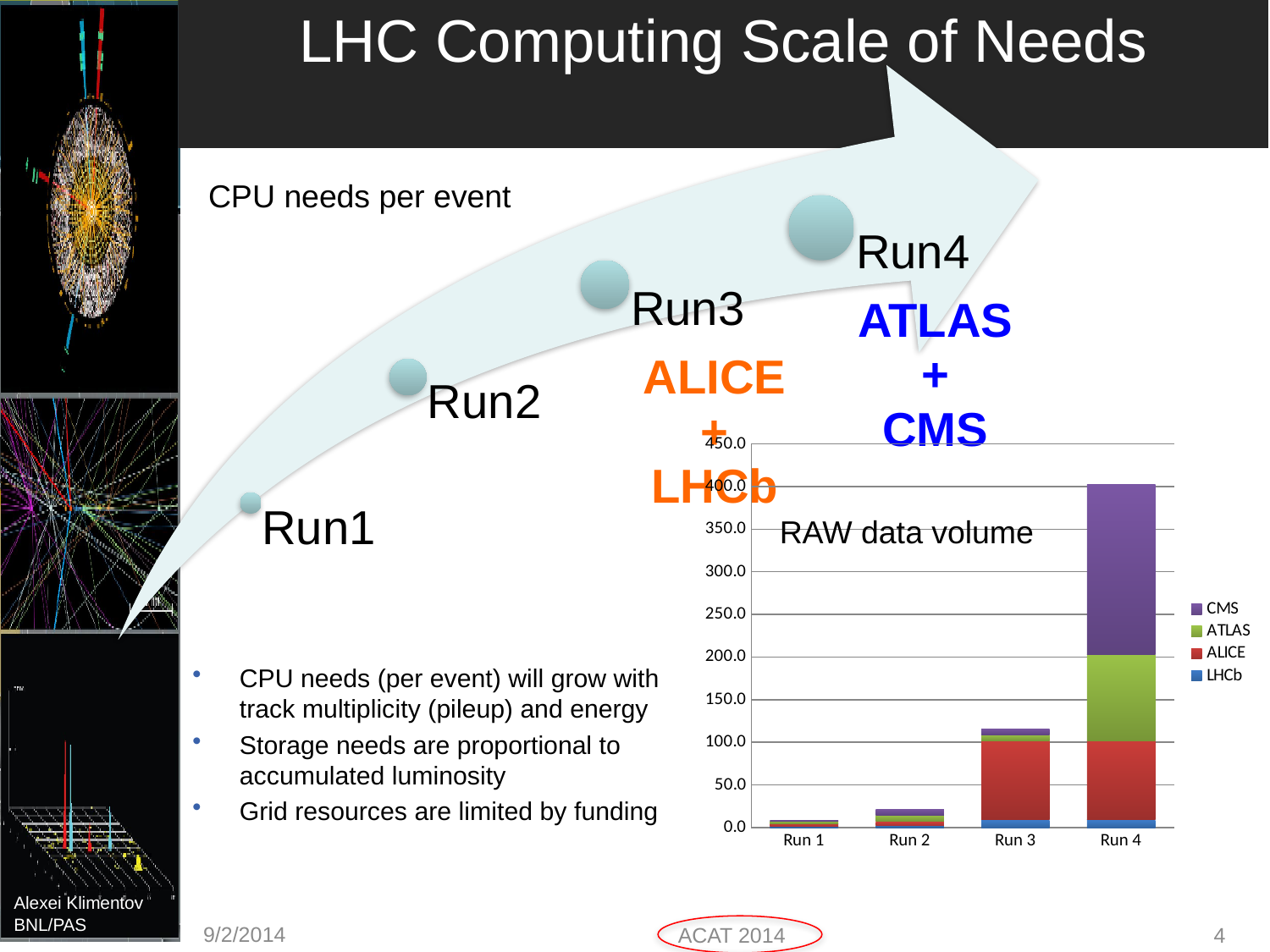
Which series is listed last in the legend of the RAW data volume chart? LHCb Is the total RAW data volume for Run 2 greater or less than 50.0? less Is the total RAW data volume for Run 3 greater or less than 100.0? greater Is the total RAW data volume for Run 4 greater or less than 350.0? greater Which series is shown in purple in the RAW data volume chart? CMS How many categories are shown on the x axis of the RAW data volume chart? 4 Which has a larger total RAW data volume, Run 3 or Run 4? Run 4 Which run has the lowest total RAW data volume? Run 1 What kind of chart is the RAW data volume chart? stacked bar chart How many series does the legend of the RAW data volume chart list? 4 Which run has the highest total RAW data volume? Run 4 Do the total RAW data volumes rise or fall from Run 1 to Run 4? rise